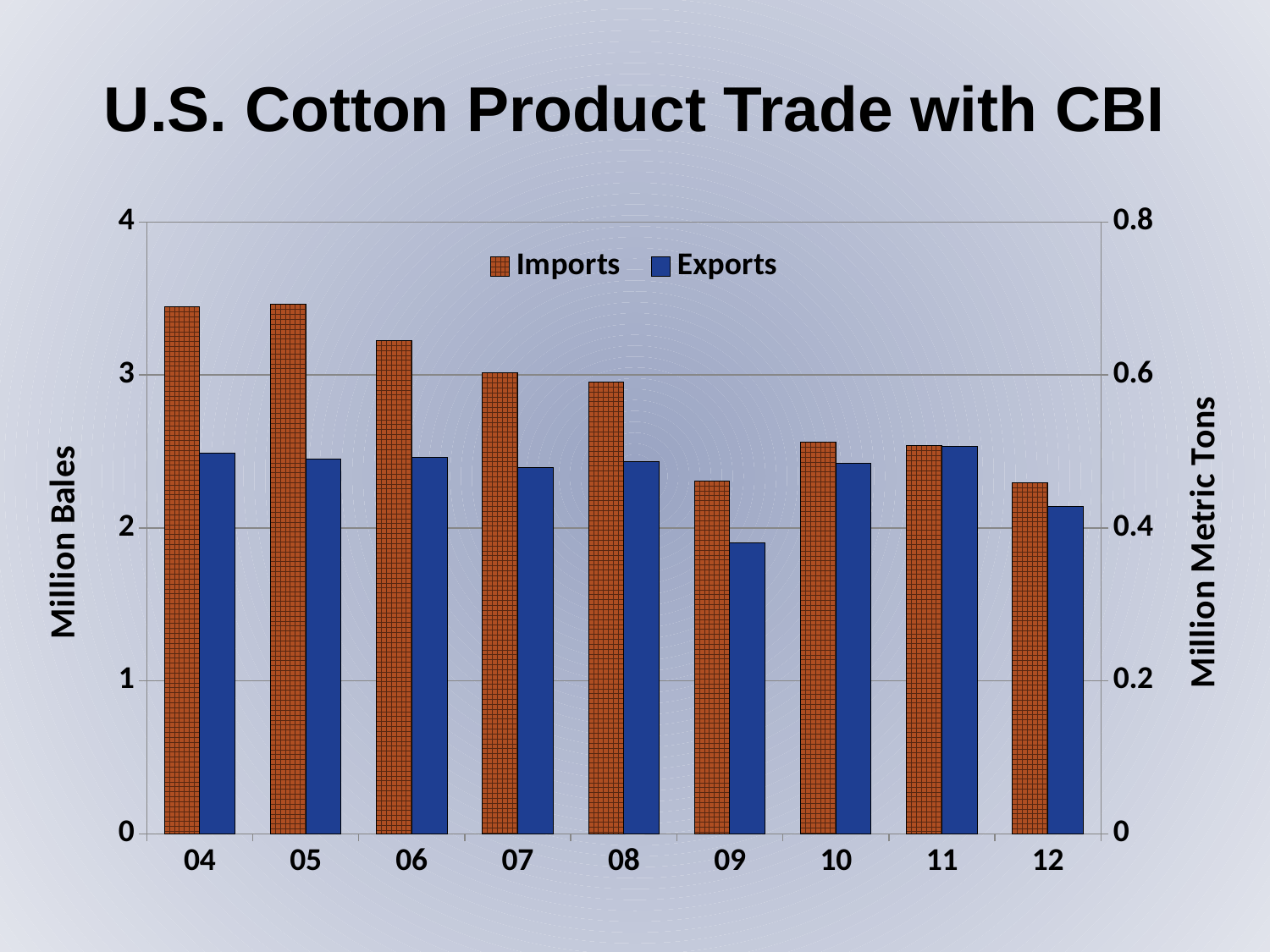
Is the Imports value for 09 greater or less than 3? less What type of chart is shown on the slide? bar chart Do the Imports values generally rise or fall from 04 to 12? fall What is the label on the left vertical axis? Million Bales Is the Exports value for 09 greater or less than 2? less Is the Imports value for 04 greater or less than 3? greater How many series does the legend list? 2 What is the title of the chart? U.S. Cotton Product Trade with CBI Which year has the lowest Exports value? 09 In 04, which is larger, Imports or Exports? Imports How many years are shown on the x axis? 9